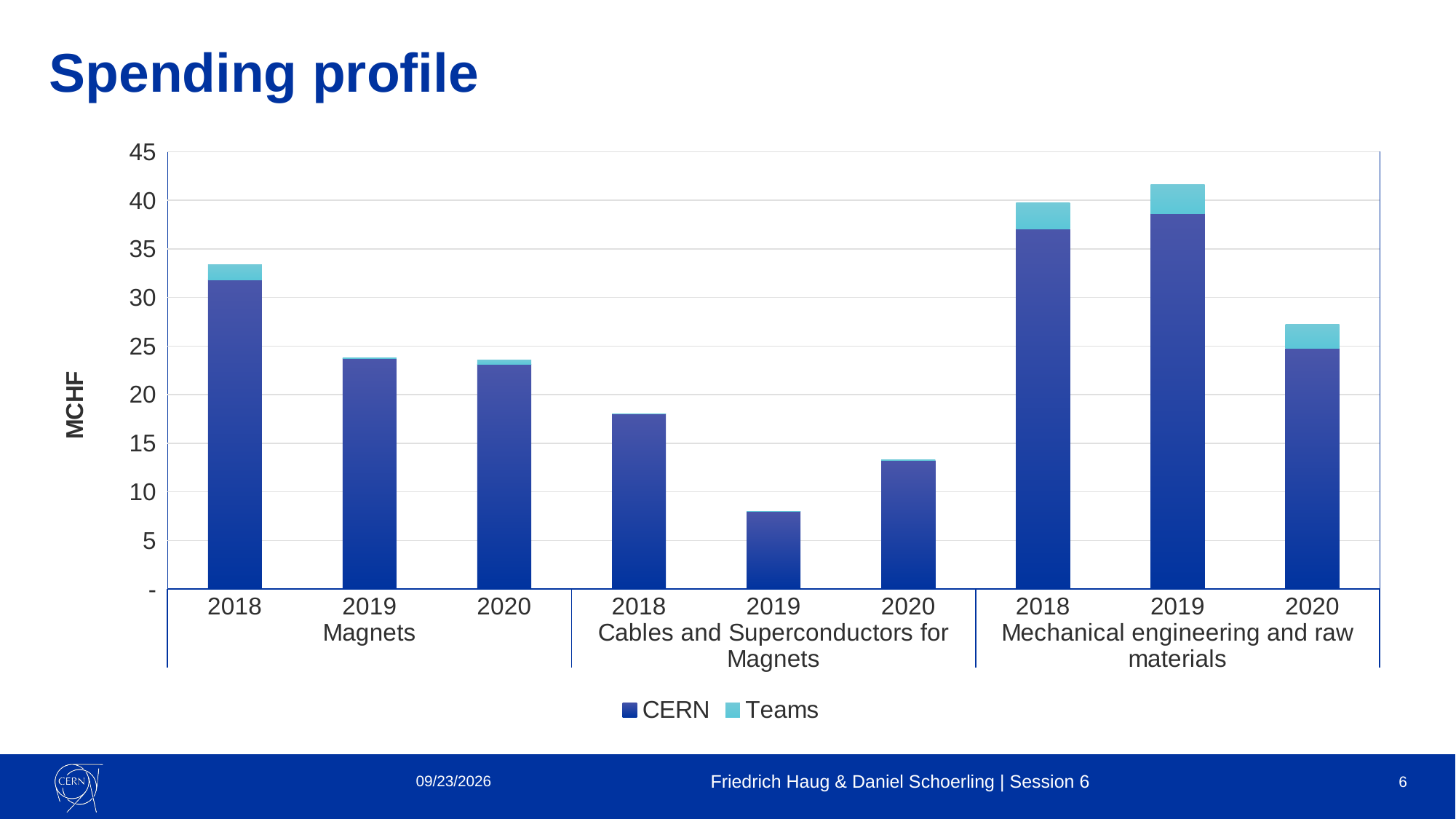
Is the total value for Mechanical engineering and raw materials in 2020 greater or less than 25? greater How many bars are plotted in the chart? 9 What is the label on the y axis? MCHF Is the total value for Magnets in 2018 greater or less than 30? greater How many spending categories (groups) are shown along the x axis? 3 What kind of chart is shown on the slide? Stacked bar chart Which bar has the highest total spending? 2019, Mechanical engineering and raw materials Which is larger for Cables and Superconductors for Magnets: the 2018 bar or the 2020 bar? 2018 Is the value for Cables and Superconductors for Magnets in 2019 greater or less than 10? less How many series does the legend list? 2 Does the total for Magnets rise or fall from 2018 to 2019? fall Which bar has the lowest total spending? 2019, Cables and Superconductors for Magnets